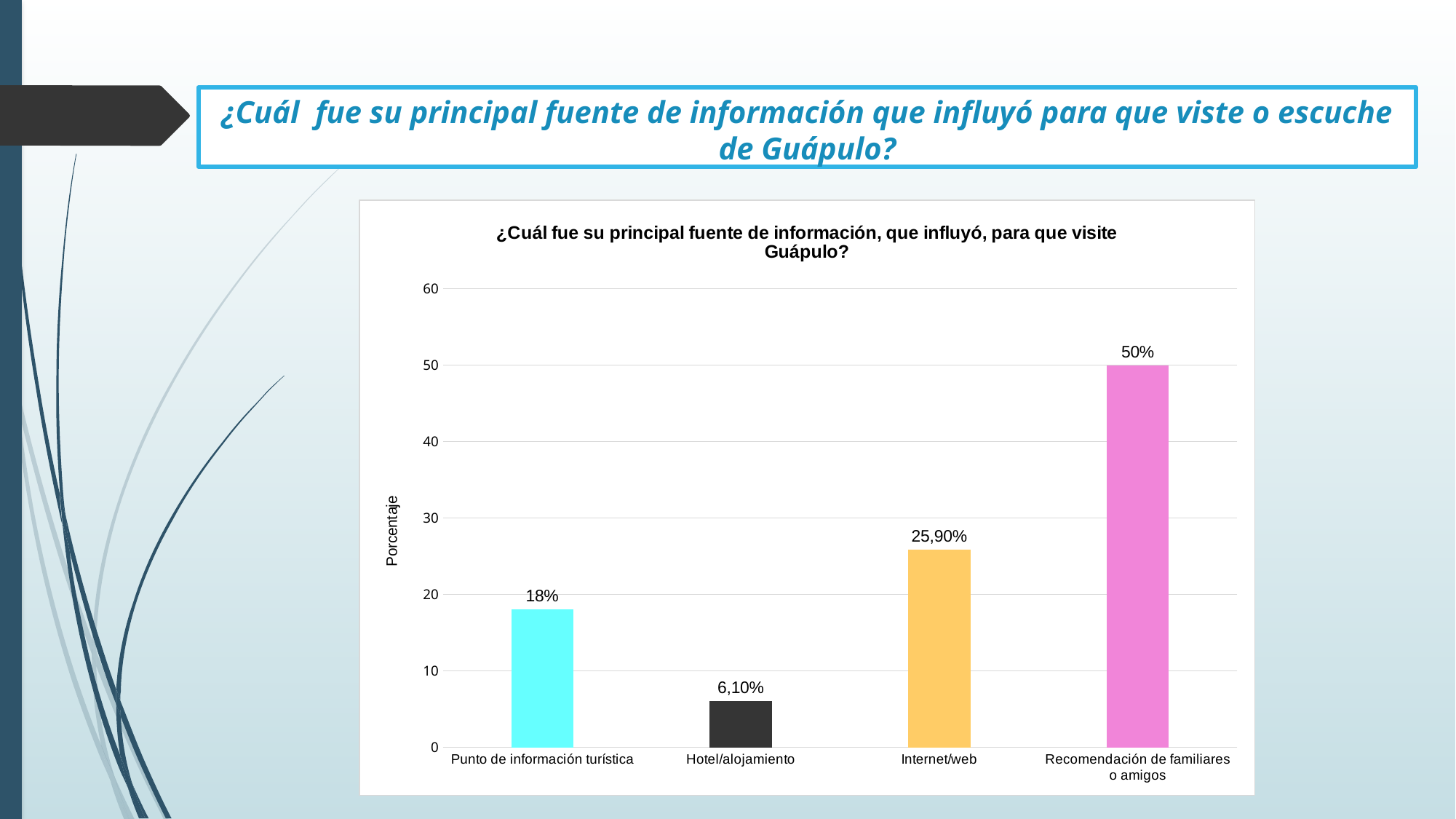
How many categories are shown on the x axis? 4 Which category has the highest value? Recomendación de familiares o amigos What is the value for Hotel/alojamiento? 6,10% Is the value for Punto de información turística greater or less than 20? less Which is larger, the value for Punto de información turística or the value for Internet/web? Internet/web What is the value for Internet/web? 25,90% What is the label of the vertical axis? Porcentaje What kind of chart is shown on the slide? bar chart What is the difference between the values for Recomendación de familiares o amigos and Internet/web? 24,10% What is the value for Punto de información turística? 18% What is the value for Recomendación de familiares o amigos? 50% Which category has the lowest value? Hotel/alojamiento